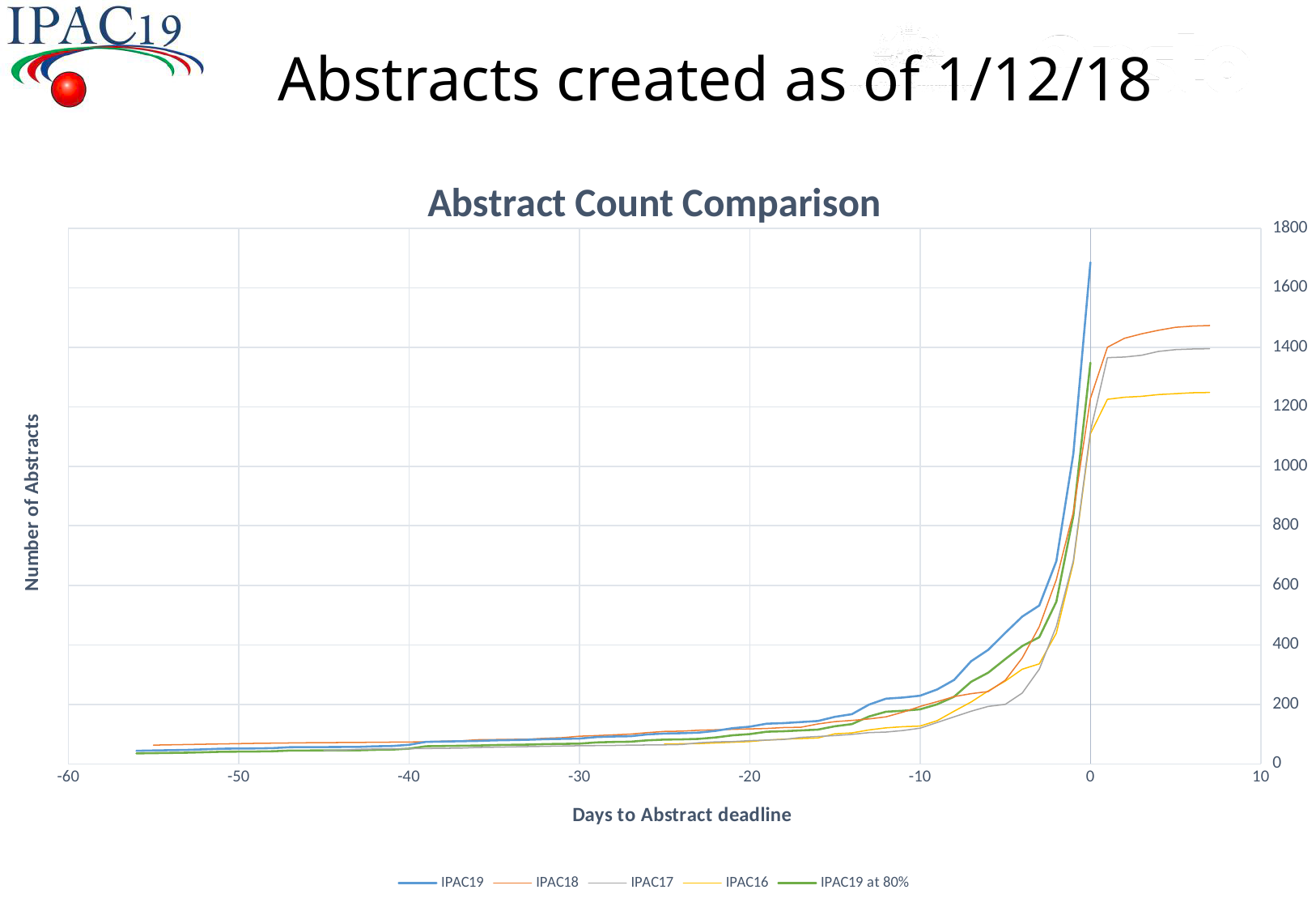
Is the value for IPAC19 at day 0 greater or less than 1600? greater Do the values for IPAC19 rise or fall as the days approach the abstract deadline? rise What is the label of the x axis? Days to Abstract deadline What is the title of the chart? Abstract Count Comparison Is the final value for IPAC18 greater or less than 1400? greater Is the value for IPAC19 at day -10 greater or less than 400? less Which series has the larger final value, IPAC18 or IPAC17? IPAC18 What kind of chart is shown on the slide? line chart Which series ends at the lowest value after the deadline? IPAC16 Which series reaches the highest value at day 0? IPAC19 How many series does the legend list? 5